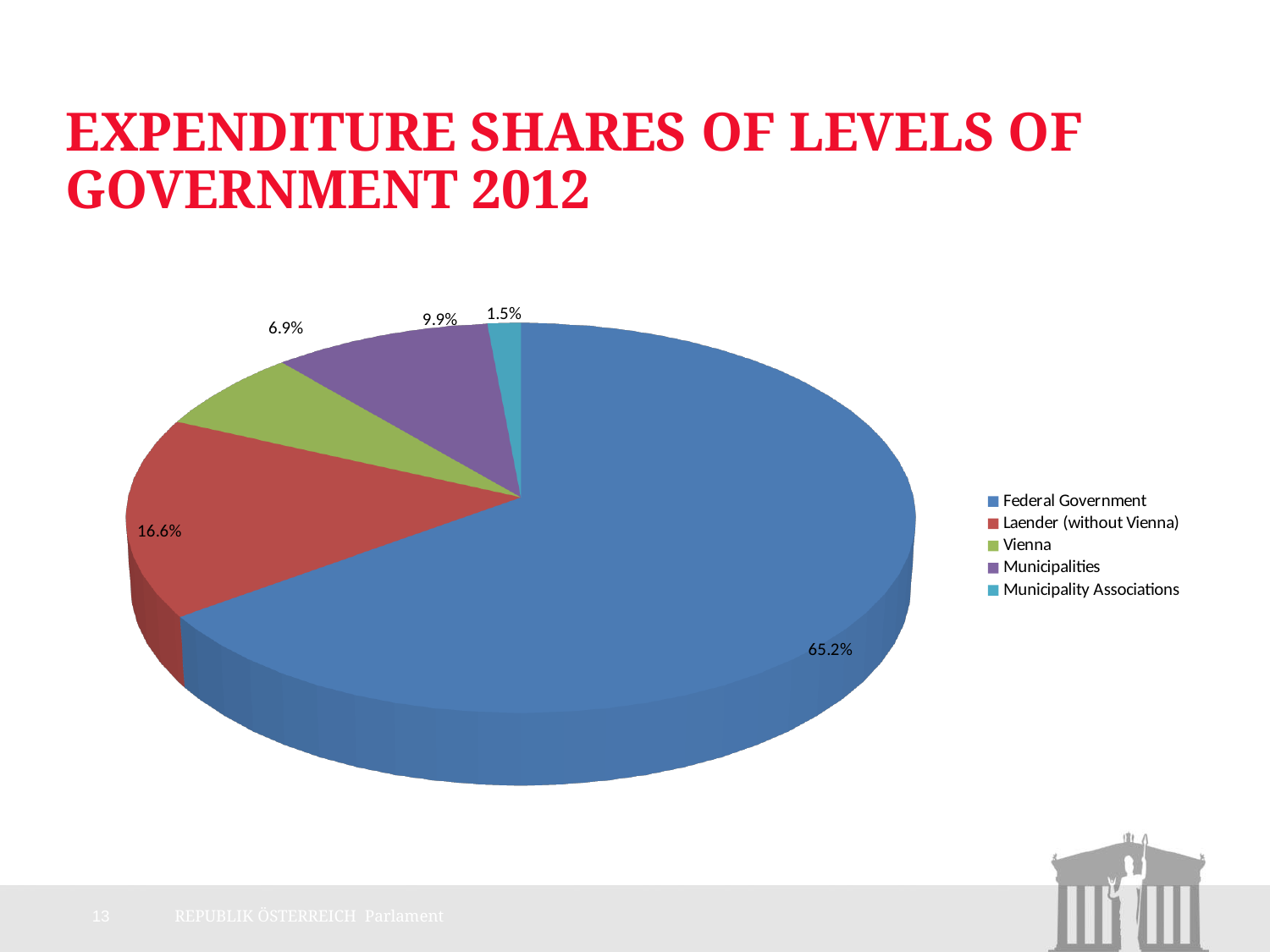
What share of expenditure do the Municipalities have? 9.9% Which level of government has the largest expenditure share? Federal Government What share of expenditure do the Municipality Associations have? 1.5% How many levels of government are shown in the pie chart? 5 What share of expenditure does Vienna have? 6.9% What share of expenditure does the Federal Government have? 65.2% What is the difference between the expenditure shares of the Federal Government and the Laender (without Vienna)? 48.6% Which has a larger expenditure share, Vienna or Municipalities? Municipalities Which level of government has the smallest expenditure share? Municipality Associations What share of expenditure do the Laender (without Vienna) have? 16.6% What is the title of the chart on the slide? Expenditure Shares of Levels of Government 2012 What kind of chart is shown on the slide? Pie chart